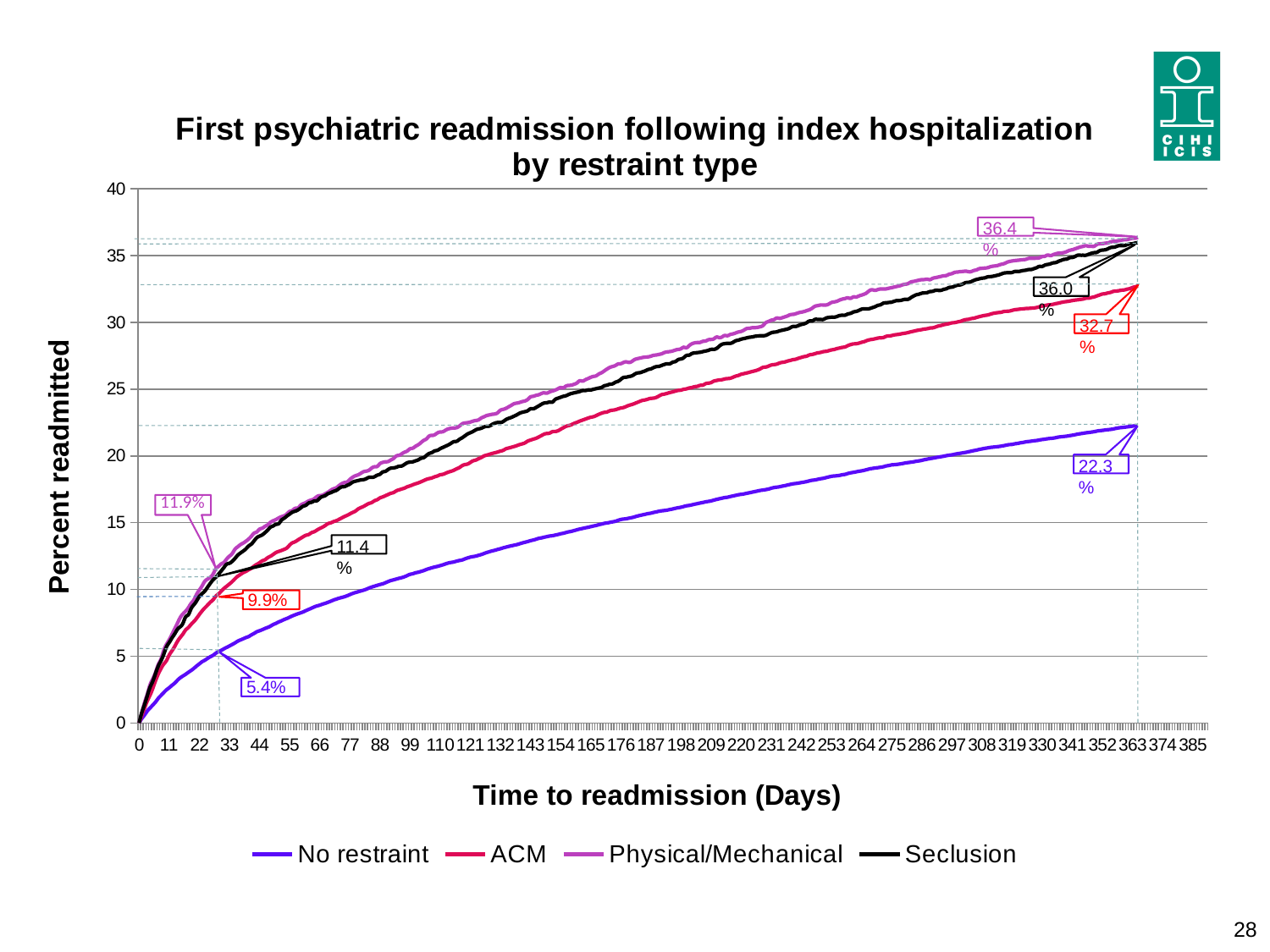
What value is shown in the early callout label for the Physical/Mechanical line near the start of the chart? 11.9% Which restraint type has the lowest labelled value at the right end of the chart? No restraint Is the value for the Physical/Mechanical line at day 198 greater or less than 25? greater Which restraint type has the highest labelled value at the right end of the chart? Physical/Mechanical What value is shown in the callout label for the Seclusion line at the right end of the chart? 36.0% What is the difference between the end-of-chart labelled values for Physical/Mechanical (36.4%) and No restraint (22.3%)? 14.1 percentage points How many series does the legend list? 4 What value is shown in the callout label for the No restraint line at the right end of the chart? 22.3% What type of chart is shown on the slide? Line chart What value is shown in the early callout label for the No restraint line near the start of the chart? 5.4% What value is shown in the callout label for the ACM line at the right end of the chart? 32.7% Do the lines rise or fall as time to readmission increases? Rise